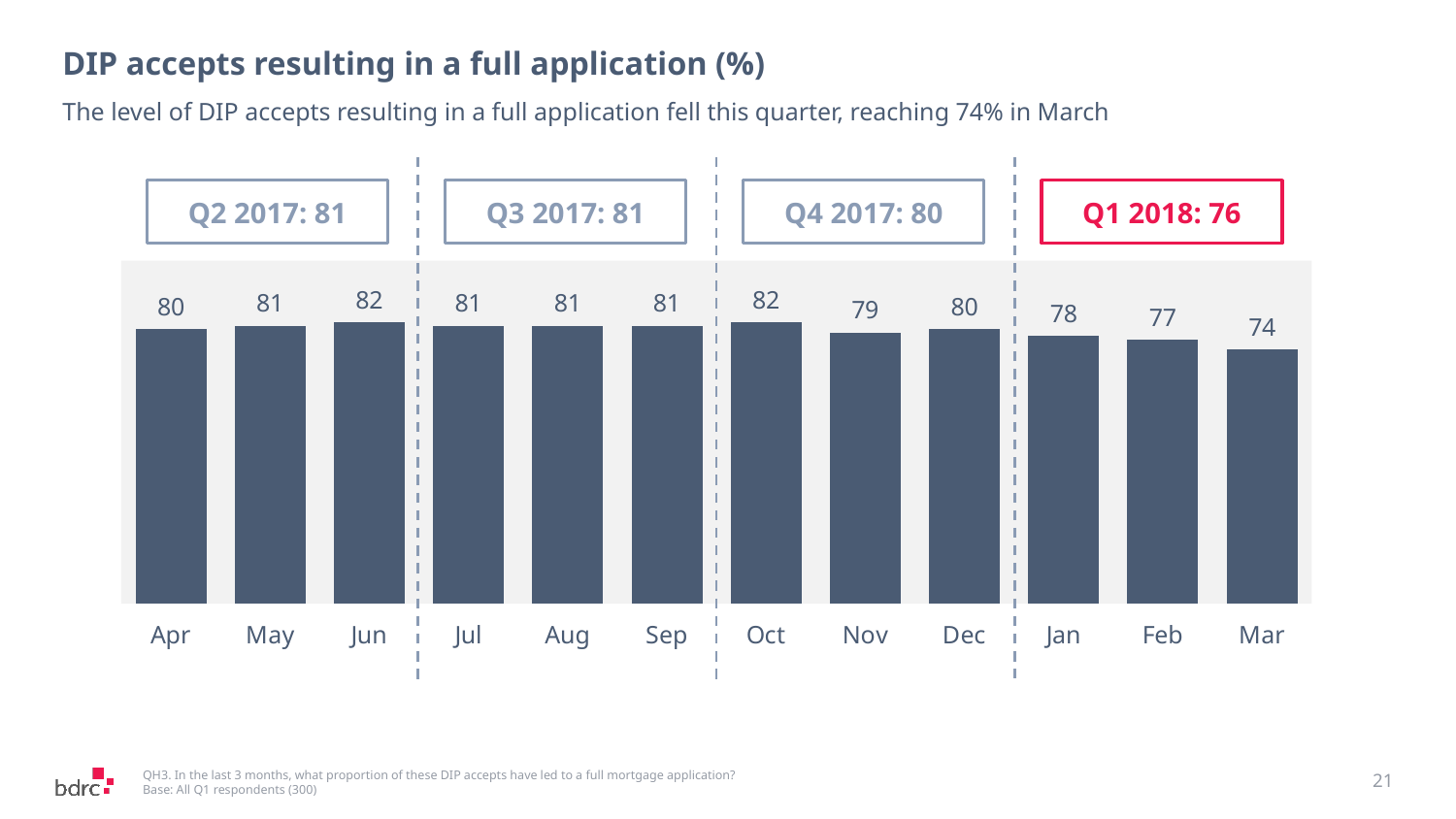
What is the difference between the values for Jun and Feb? 5 What is the value for Nov? 79 Do the values rise or fall from Jan to Mar? fall What is the value for Mar? 74 Which month has the lowest value? Mar What is the title of the chart? DIP accepts resulting in a full application (%) What is the value for Oct? 82 How many months are plotted on the chart? 12 Which is larger, the value for Apr or the value for Mar? Apr What is the quarterly figure shown for Q1 2018? 76 What kind of chart is shown? bar chart What is the difference between the values for Jan and Mar? 4